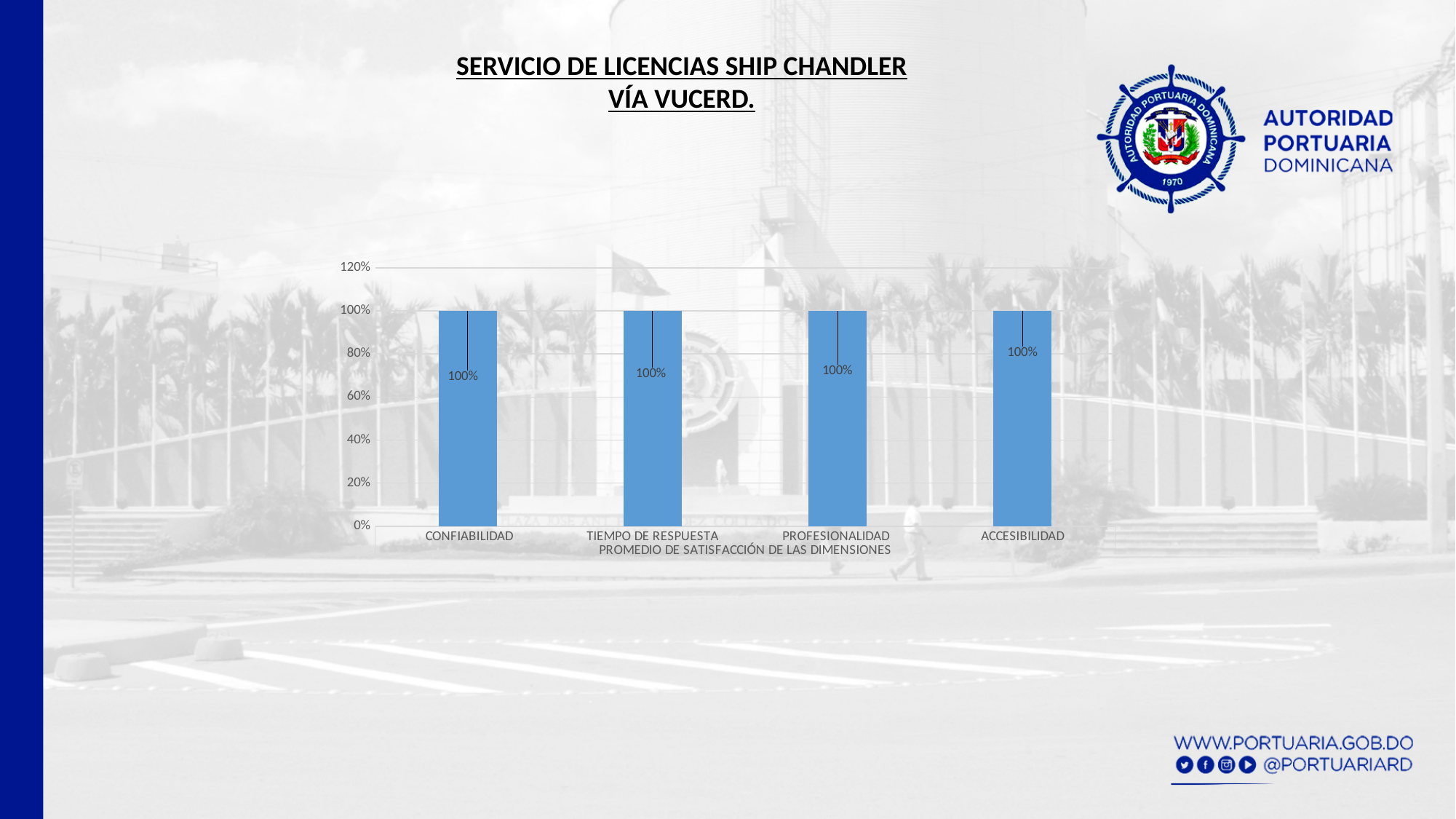
What is the value for CONFIABILIDAD? 100% Is the value for PROFESIONALIDAD greater or less than 80%? greater What is the difference between the values for CONFIABILIDAD and ACCESIBILIDAD? 0% What is the title shown above the chart on the slide? SERVICIO DE LICENCIAS SHIP CHANDLER VÍA VUCERD. How many categories are shown on the x axis? 4 What is the value for TIEMPO DE RESPUESTA? 100% What kind of chart is shown on the slide? bar chart What is the value for ACCESIBILIDAD? 100% Do the values rise, fall or stay the same across the categories from left to right? stay the same What is the value for PROFESIONALIDAD? 100% What is the title of the x axis of the chart? PROMEDIO DE SATISFACCIÓN DE LAS DIMENSIONES Is the value for TIEMPO DE RESPUESTA greater or less than 120%? less